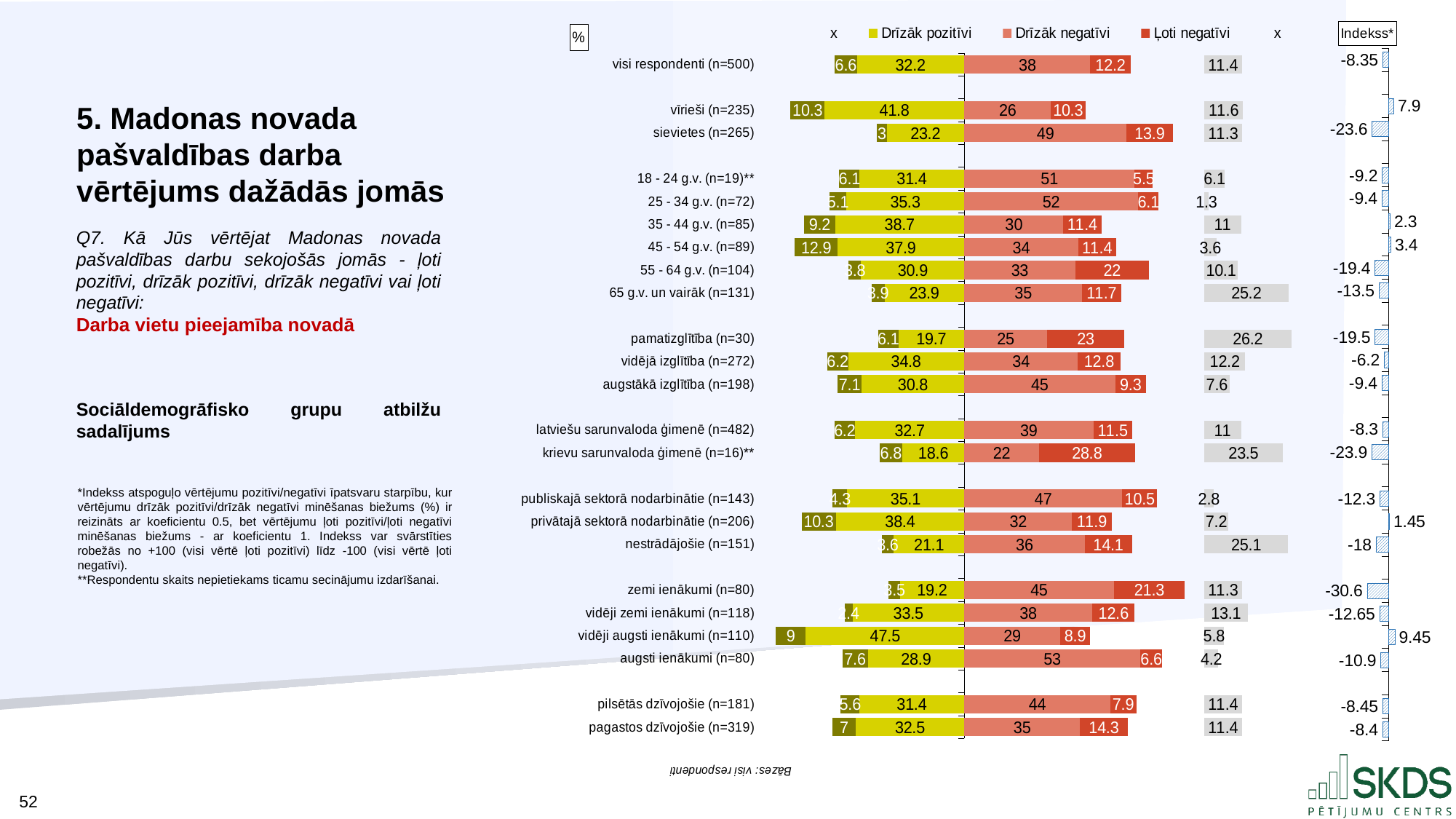
What is the Indekss* value for 'visi respondenti (n=500)'? -8.35 Which group has the lowest Indekss* value? zemi ienākumi (n=80) Which group has the highest 'Drīzāk negatīvi' value? augsti ienākumi (n=80) What is the 'Drīzāk pozitīvi' value for 'visi respondenti (n=500)'? 32.2 What is the difference between the 'Drīzāk negatīvi' values for 'sievietes (n=265)' and 'vīrieši (n=235)'? 23 What is the 'Ļoti negatīvi' value for 'krievu sarunvaloda ģimenē (n=16)**'? 28.8 What is the Indekss* value for 'vidēji augsti ienākumi (n=110)'? 9.45 What is the 'Drīzāk negatīvi' value for 'sievietes (n=265)'? 49 Which group has the highest 'Drīzāk pozitīvi' value? vidēji augsti ienākumi (n=110) What kind of chart is shown on the slide? bar chart How many respondent groups are plotted in the chart? 23 Which has the larger 'Drīzāk pozitīvi' value, 'vīrieši (n=235)' or 'sievietes (n=265)'? vīrieši (n=235)